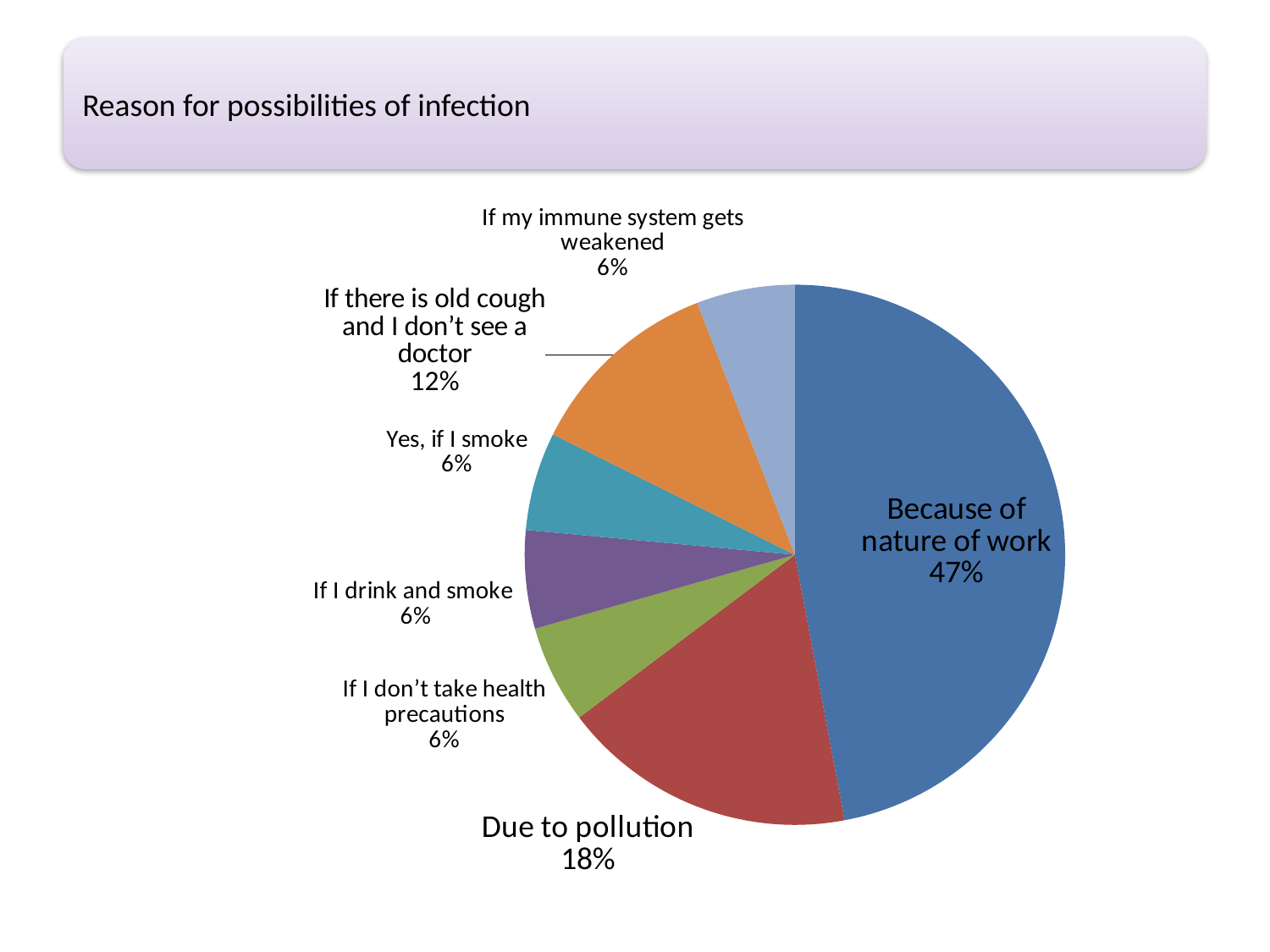
Which category has the largest slice of the pie? Because of nature of work What share of the pie is 'Because of nature of work'? 47% What share of the pie is 'If there is old cough and I don't see a doctor'? 12% What colour is the 'Due to pollution' slice? red What is the difference in percentage points between 'Because of nature of work' and 'Due to pollution'? 29 What share of the pie is 'Due to pollution'? 18% What is the difference in percentage points between 'If there is old cough and I don't see a doctor' and 'If I drink and smoke'? 6 What kind of chart is shown on the slide? pie chart How many slices does the pie chart have? 7 Which is larger, 'Due to pollution' or 'If there is old cough and I don't see a doctor'? Due to pollution What is the title shown above the chart on the slide? Reason for possibilities of infection